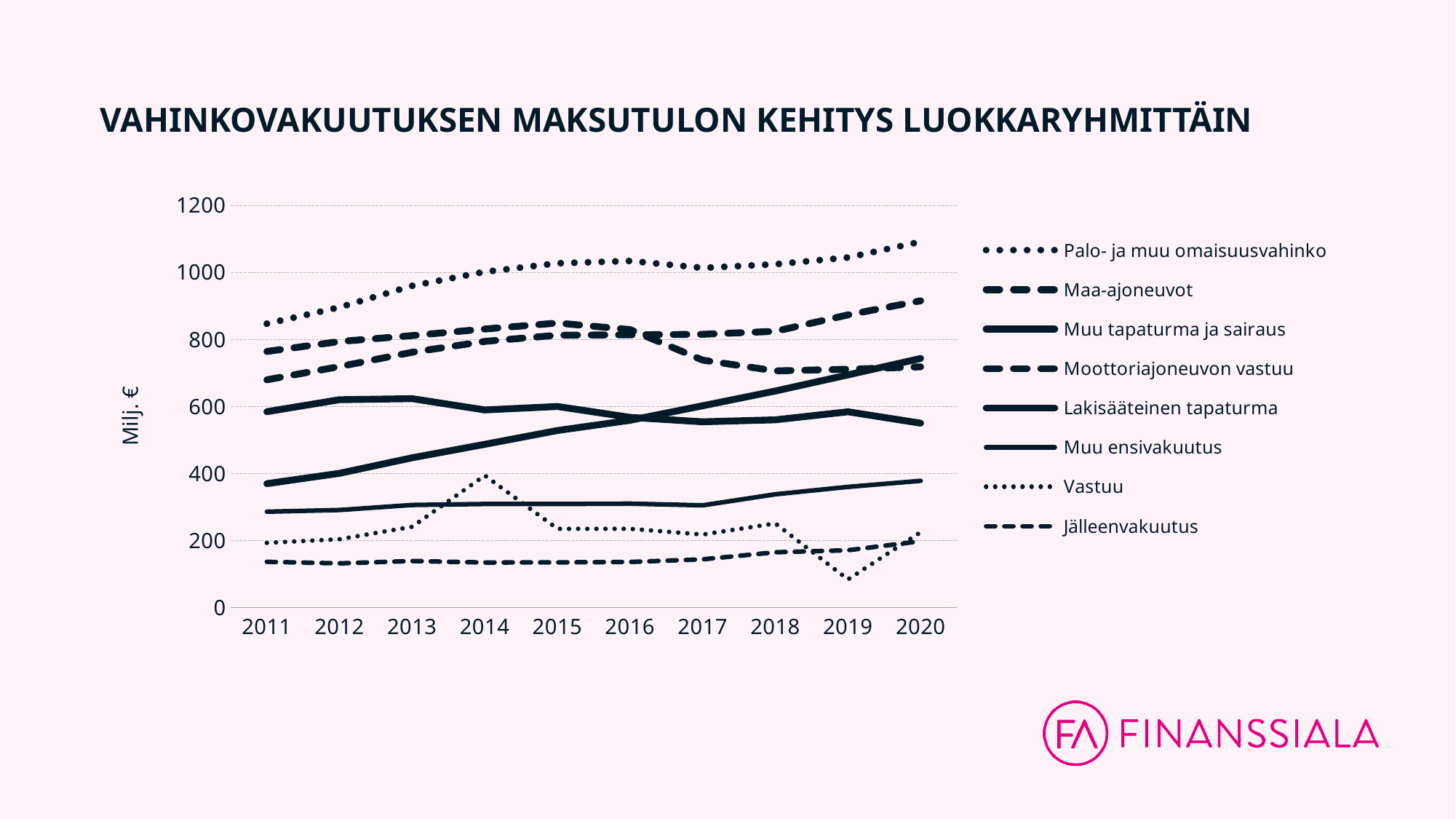
What is the label on the y axis? Milj. € In 2020, which is larger: Maa-ajoneuvot or Moottoriajoneuvon vastuu? Maa-ajoneuvot In which year does the Vastuu series reach its highest value? 2014 Which series has the lowest value in 2011? Jälleenvakuutus Is the value for Palo- ja muu omaisuusvahinko in 2020 greater or less than 1000? greater Is the value for Vastuu in 2019 greater or less than 200? less Is the value for Muu tapaturma ja sairaus in 2011 greater or less than 400? less Which series has the highest value in 2020? Palo- ja muu omaisuusvahinko Does the Muu tapaturma ja sairaus series rise or fall from 2011 to 2020? Rise What kind of chart is shown on the slide? Line chart How many series does the legend list? 8 How many years are shown on the x axis? 10